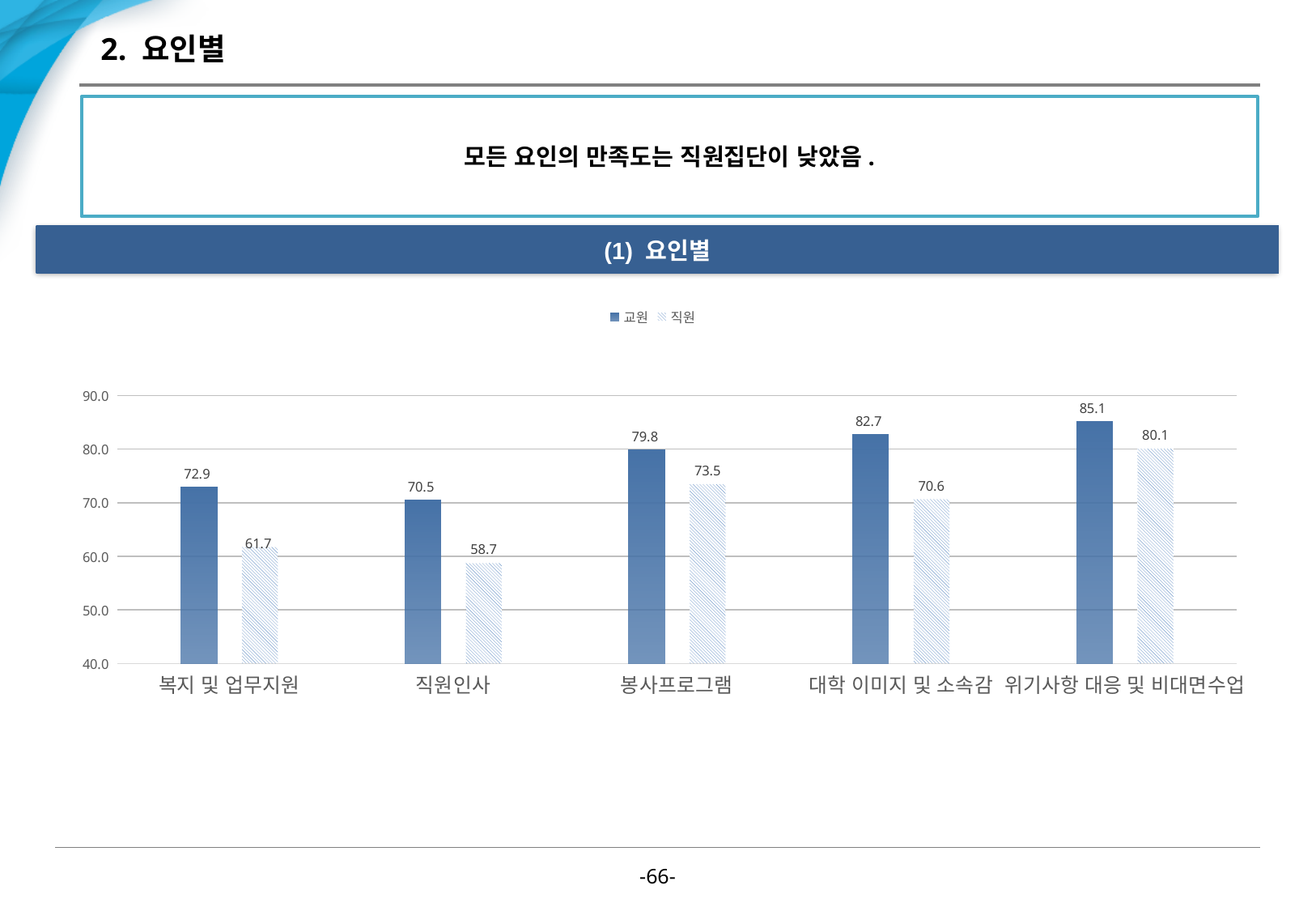
How many series does the legend list? 2 What kind of chart is shown on the slide? bar chart What is the value for 직원 in the 직원인사 category? 58.7 What is the value for 교원 in the 복지 및 업무지원 category? 72.9 Which is larger in the 봉사프로그램 category, the 교원 value or the 직원 value? 교원 What is the value for 교원 in the 위기사항 대응 및 비대면수업 category? 85.1 What are the two series named in the legend? 교원 and 직원 What is the value for 직원 in the 봉사프로그램 category? 73.5 Which category has the highest value for 교원? 위기사항 대응 및 비대면수업 Which category has the lowest value for 직원? 직원인사 How many categories are shown on the x axis? 5 What is the difference between the 교원 and 직원 values in the 대학 이미지 및 소속감 category? 12.1